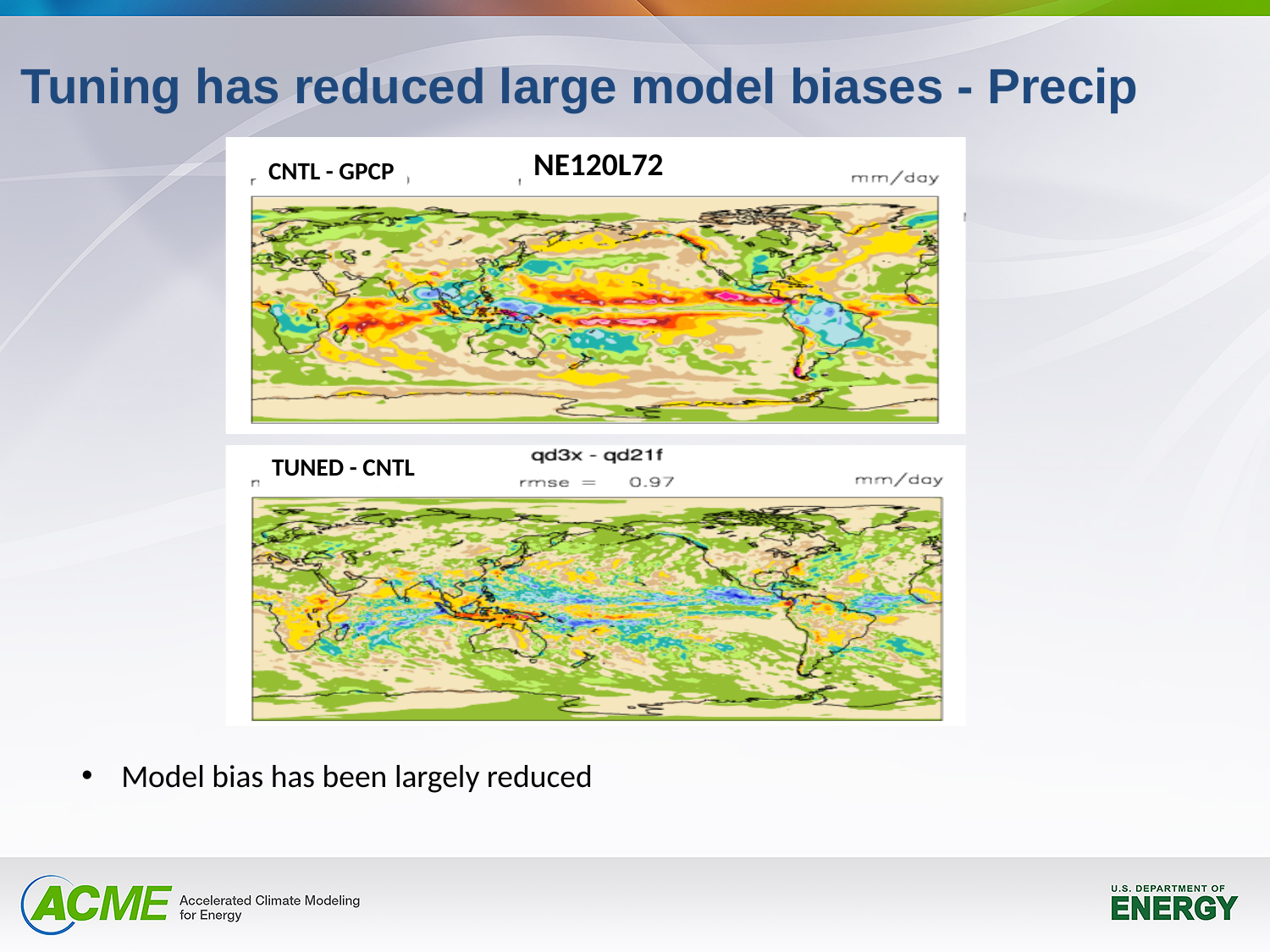
What kind of plot is shown in the two panels on the slide? map What is the label of the upper map panel on the slide? CNTL - GPCP How many map panels are shown on the slide? 2 What unit is shown for the values in the upper map (CNTL - GPCP)? mm/day What is the rmse value printed on the lower map (TUNED - CNTL)? 0.97